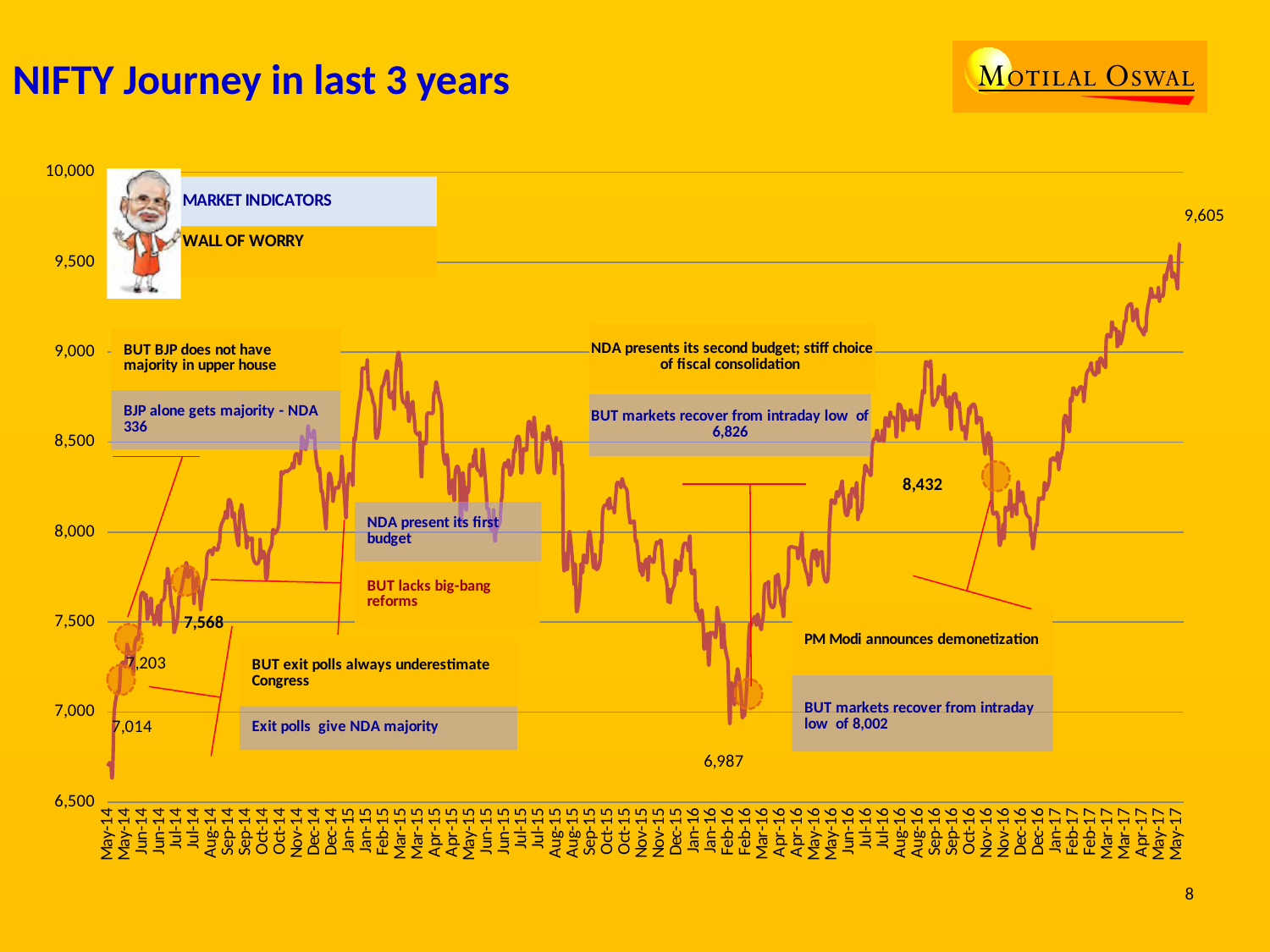
What is the highest NIFTY value labelled on the chart? 9,605 Overall, does the NIFTY line rise or fall from May-14 to May-17? rise Which labelled value is larger, 7,568 or 7,203? 7,568 What is the difference between the labelled end value of 9,605 and the labelled start value of 7,014? 2,591 What kind of chart is shown on the slide? line chart What is the NIFTY value labelled near the demonetization announcement in late 2016? 8,432 What is the lowest NIFTY value labelled on the chart? 6,987 What is the title of the chart on the slide? NIFTY Journey in last 3 years What is the NIFTY value labelled at the low point around Feb-16? 6,987 What is the NIFTY value labelled at the end of the line in May-17? 9,605 Is the NIFTY value at its peak around Mar-15 greater or less than 8,500? greater What is the NIFTY value labelled at the start of the line in May-14? 7,014